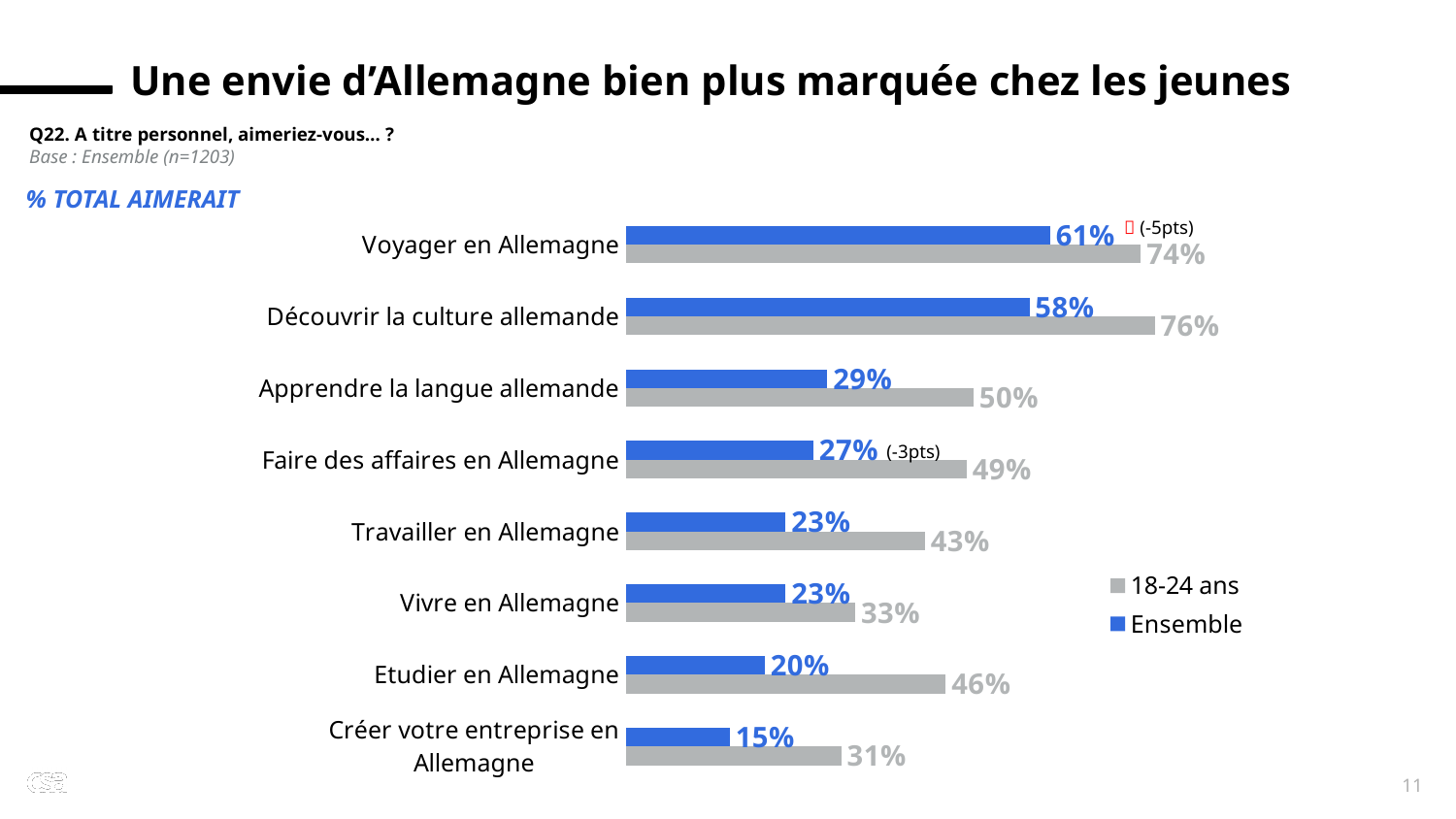
How many categories are shown in the chart? 8 How many series does the legend list? 2 What is the value for 18-24 ans for "Découvrir la culture allemande"? 76% What is the difference between the 18-24 ans and Ensemble values for "Apprendre la langue allemande"? 21 points What is the value for Ensemble for "Créer votre entreprise en Allemagne"? 15% Which colour represents the Ensemble series in the chart? Blue Which category has the highest value for the 18-24 ans series? Découvrir la culture allemande What is the value for 18-24 ans for "Etudier en Allemagne"? 46% What kind of chart is shown on the slide? Bar chart What is the value for Ensemble for "Voyager en Allemagne"? 61% Which is larger for "Vivre en Allemagne": the 18-24 ans value or the Ensemble value? 18-24 ans Which category has the lowest value for the Ensemble series? Créer votre entreprise en Allemagne